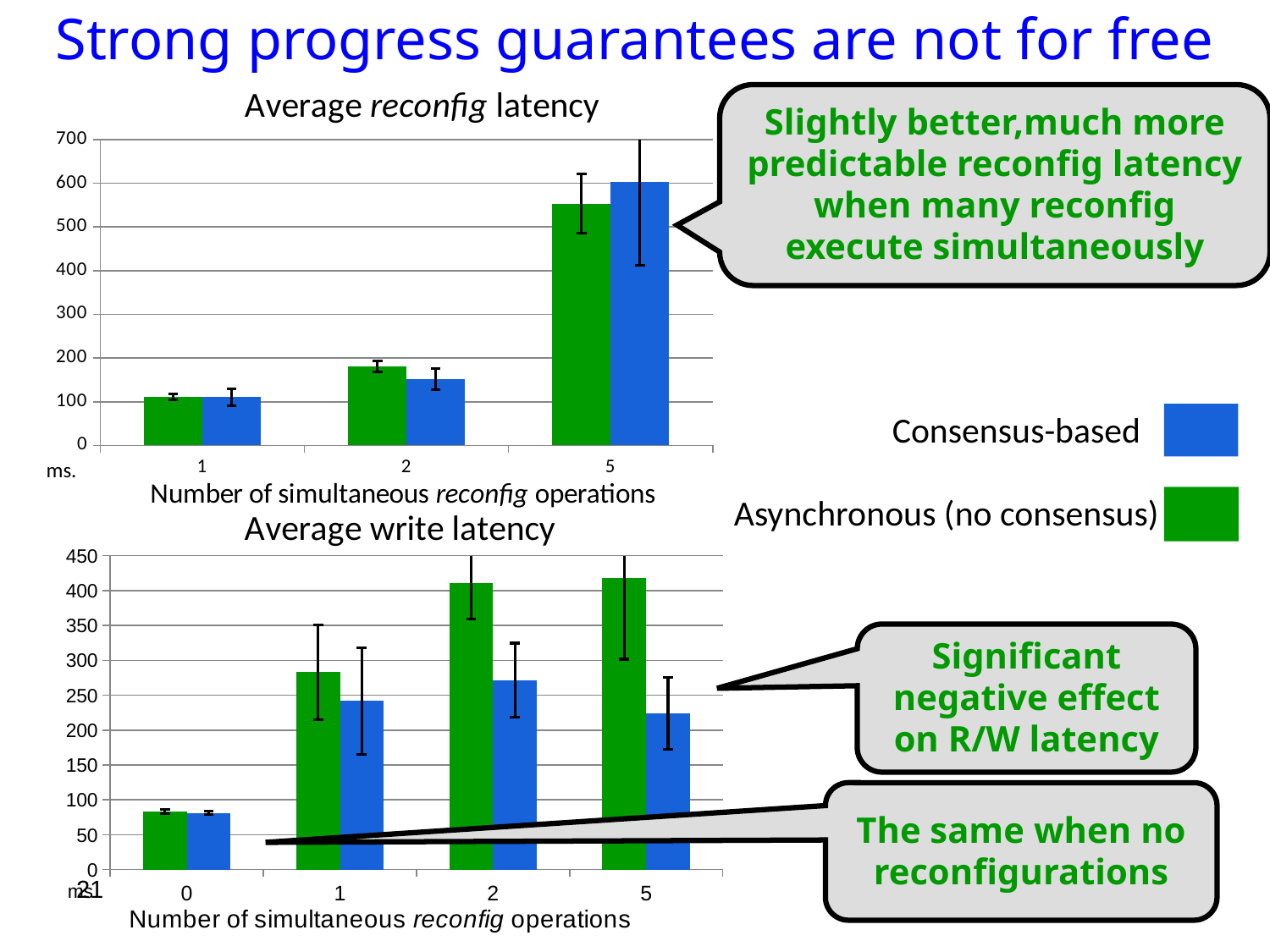
In the 'Average reconfig latency' chart, do the Consensus-based values rise or fall as the number of simultaneous reconfig operations increases? rise What kind of chart is the 'Average reconfig latency' chart? bar chart In the 'Average write latency' chart, is the Asynchronous (no consensus) value for 0 simultaneous reconfig operations greater or less than 100? less In the 'Average write latency' chart, is the Consensus-based value for 5 simultaneous reconfig operations greater or less than 250? less How many categories are on the x axis of the 'Average write latency' chart? 4 In the 'Average write latency' chart, at 5 simultaneous reconfig operations, which series has the larger value: Consensus-based or Asynchronous (no consensus)? Asynchronous (no consensus) In the 'Average reconfig latency' chart, is the Asynchronous (no consensus) value for 2 simultaneous reconfig operations greater or less than 200? less In the 'Average write latency' chart, which number of simultaneous reconfig operations has the lowest Asynchronous (no consensus) latency? 0 In the 'Average reconfig latency' chart, which number of simultaneous reconfig operations has the highest Consensus-based latency? 5 How many categories are on the x axis of the 'Average reconfig latency' chart? 3 How many series does the legend list? 2